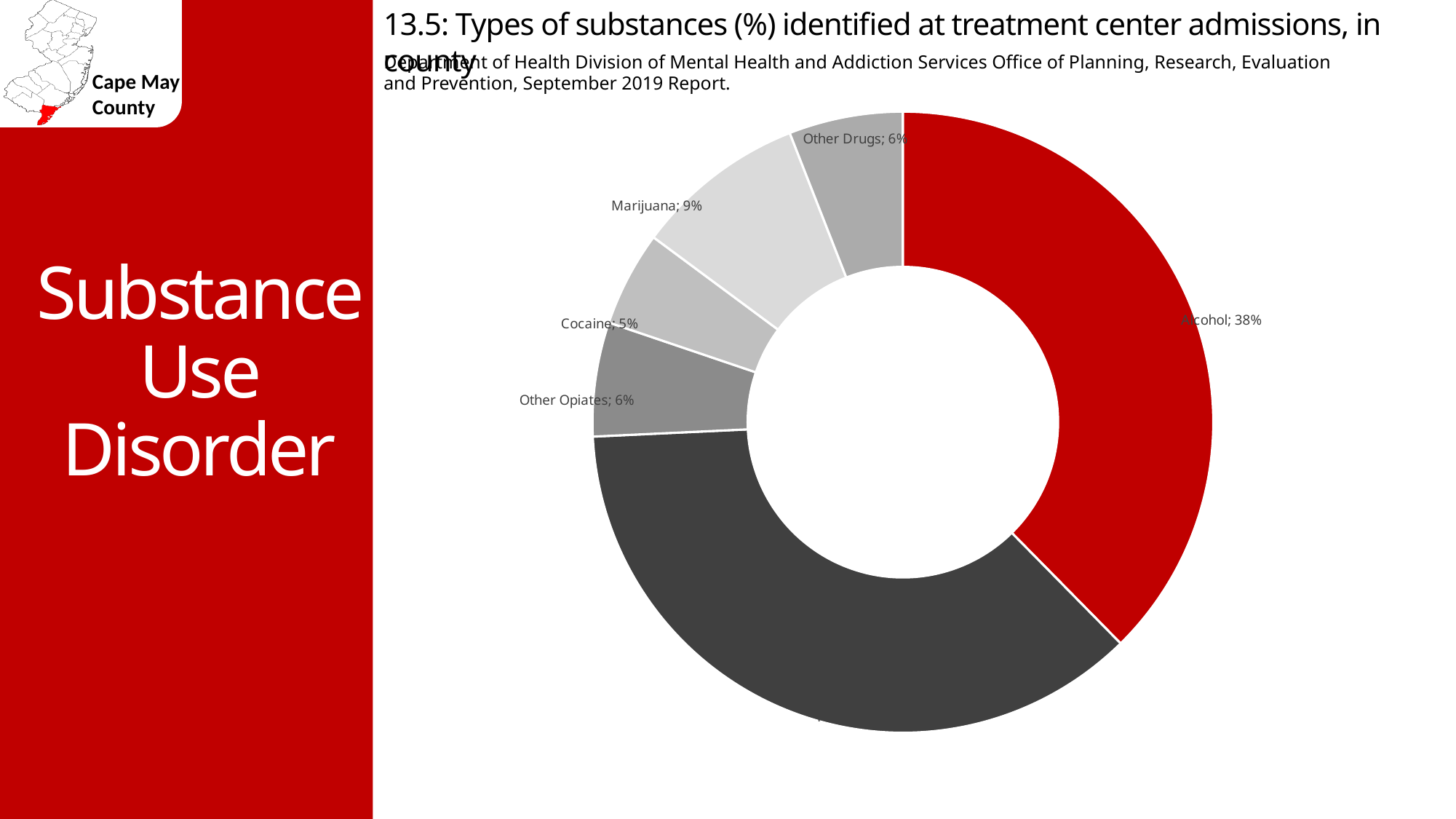
How many percentage points higher is Alcohol than Marijuana? 29 What percentage is shown for Cocaine? 5% What percentage is shown for Other Drugs? 6% What percentage of treatment center admissions is attributed to Alcohol? 38% How many percentage points higher is Marijuana than Cocaine? 4 Which is larger, the share for Alcohol or the share for Marijuana? Alcohol Among the labeled substances, which has the smallest share? Cocaine How many slices does the chart have? 6 What percentage is shown for Marijuana? 9% Which is larger, the share for Marijuana or the share for Cocaine? Marijuana What kind of chart is shown on the slide? Doughnut (pie) chart What percentage is shown for Other Opiates? 6%